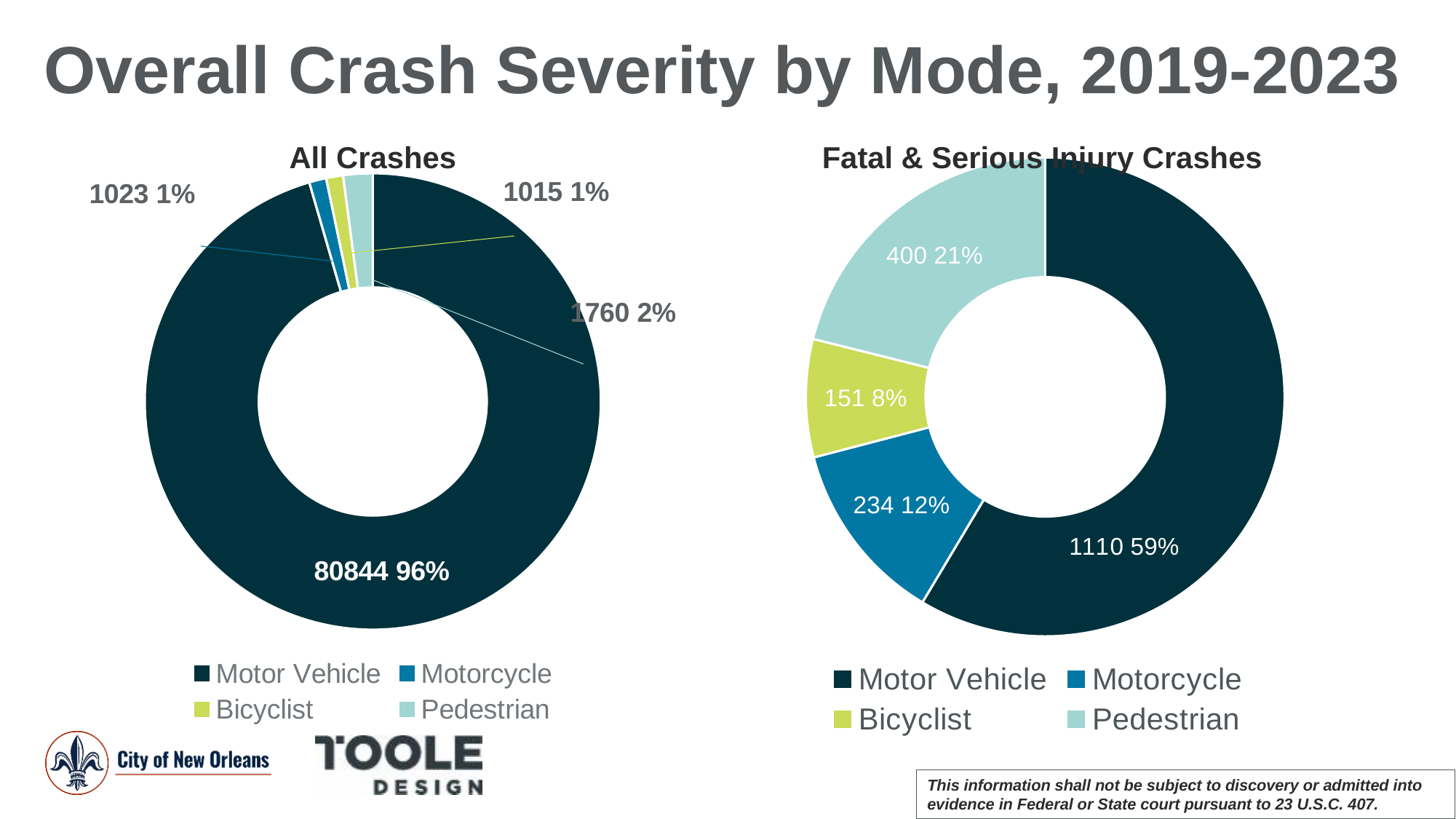
In the Fatal & Serious Injury Crashes chart, what is the value shown for Motorcycle? 234 12% In the Fatal & Serious Injury Crashes chart, which is larger, Pedestrian or Motorcycle? Pedestrian What type of chart is the All Crashes chart? Donut (pie) chart In the Fatal & Serious Injury Crashes chart, what is the difference between the Pedestrian count and the Motorcycle count? 166 In the All Crashes chart, what is the value shown for Motor Vehicle? 80844 96% In the Fatal & Serious Injury Crashes chart, what is the value shown for Pedestrian? 400 21% How many categories does the legend of the All Crashes chart list? 4 In the Fatal & Serious Injury Crashes chart, which category has the smallest slice? Bicyclist In the Fatal & Serious Injury Crashes chart, which category has the largest slice? Motor Vehicle In the Fatal & Serious Injury Crashes chart, what share of the total does Motor Vehicle represent? 59% In the Fatal & Serious Injury Crashes chart, what is the value shown for Bicyclist? 151 8% What is the title of the chart on the right side of the slide? Fatal & Serious Injury Crashes